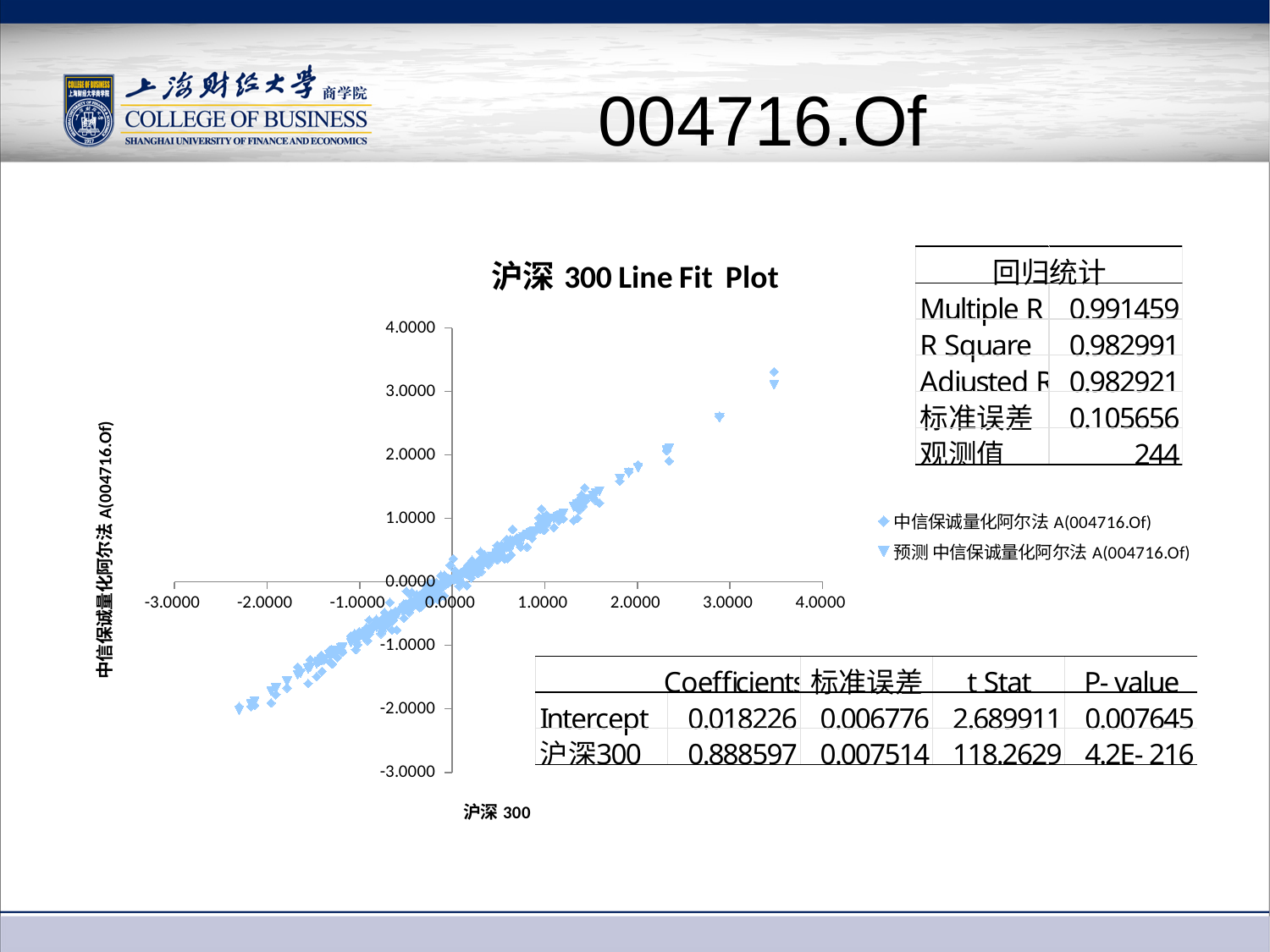
How many series does the legend of the 沪深 300 Line Fit Plot list? 2 What is the label of the x axis of the 沪深 300 Line Fit Plot? 沪深 300 In the 沪深 300 Line Fit Plot, is the lowest plotted y value greater or less than -1.0000? less What is the maximum value shown on the y axis of the 沪深 300 Line Fit Plot? 4.0000 What kind of chart is the 沪深 300 Line Fit Plot? scatter plot In the 沪深 300 Line Fit Plot, is the largest x value of the plotted points greater or less than 3.0000? greater What is the minimum value shown on the x axis of the 沪深 300 Line Fit Plot? -3.0000 In the 沪深 300 Line Fit Plot, is the highest plotted y value greater or less than 3.0000? greater What is the title of the chart on the slide? 沪深 300 Line Fit Plot In the 沪深 300 Line Fit Plot, do the plotted values rise or fall as the x-axis value increases? rise